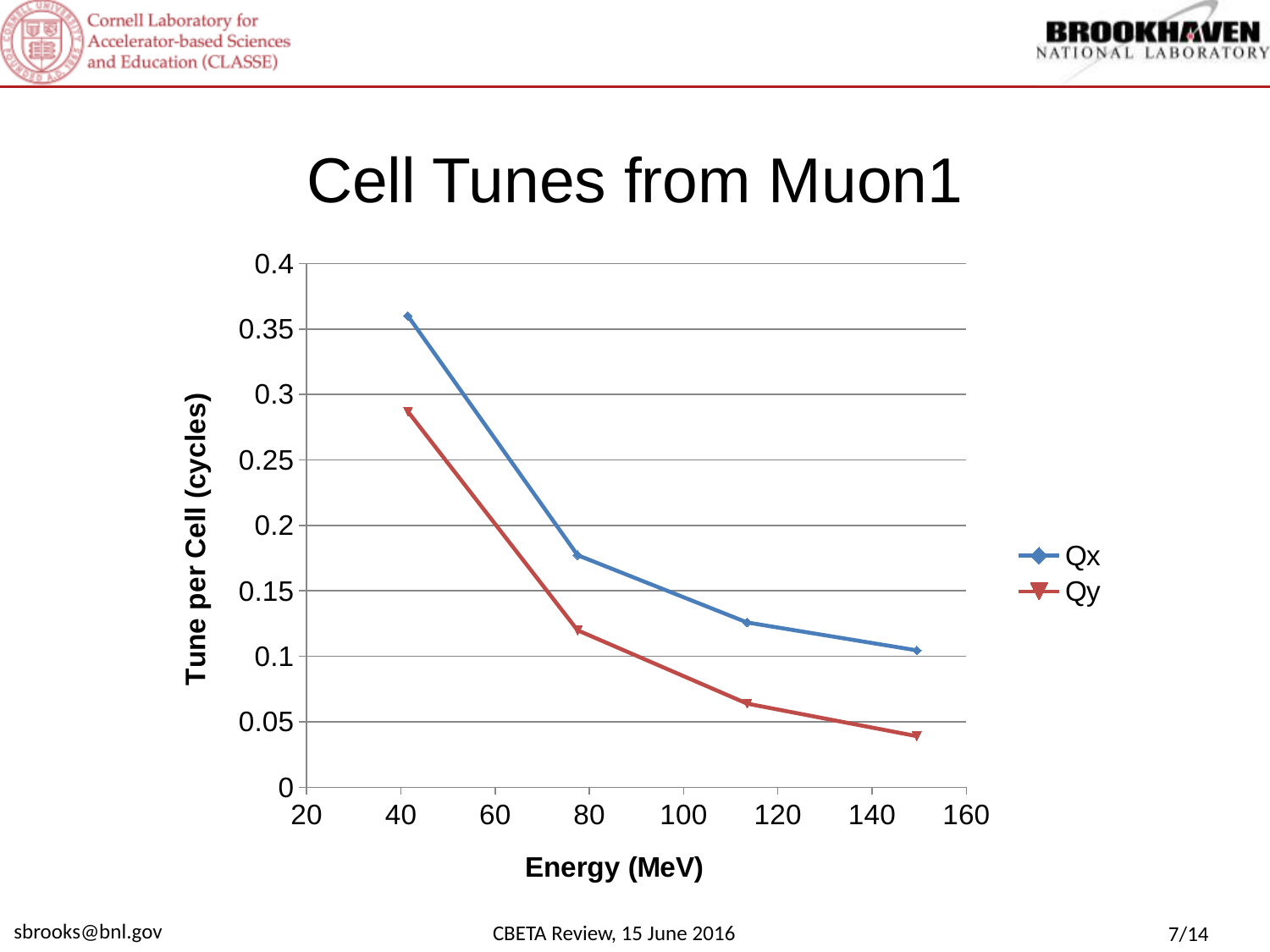
At the lowest energy plotted, which series has the larger tune per cell, Qx or Qy? Qx How many series does the legend list? 2 Is the Qx value at the lowest energy plotted greater or less than 0.3? greater Is the Qx value at the highest energy plotted greater or less than 0.15? less What is the label of the y axis? Tune per Cell (cycles) Is the Qy value at the highest energy plotted greater or less than 0.05? less What are the names of the two series in the legend? Qx and Qy How many data points are plotted for the Qx series? 4 As energy increases along the x axis, do the Qx values rise or fall? fall What kind of chart is shown on the slide? line chart As energy increases along the x axis, do the Qy values rise or fall? fall